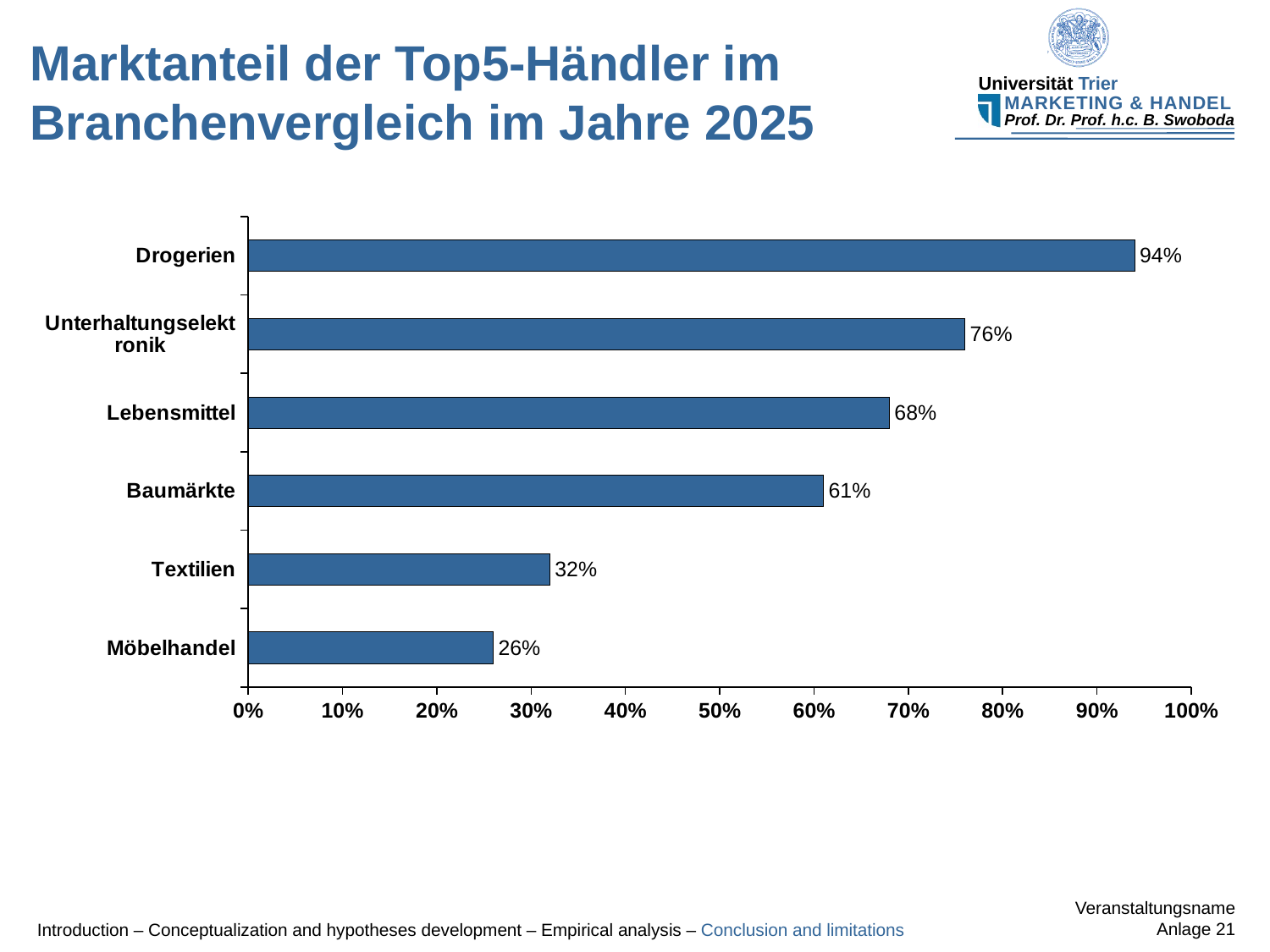
What is the title of the slide? Marktanteil der Top5-Händler im Branchenvergleich im Jahre 2025 What is the value shown for Möbelhandel? 26% What is the difference between the values for Textilien and Möbelhandel? 6% What is the value shown for Lebensmittel? 68% What is the difference between the values for Drogerien and Unterhaltungselektronik? 18% What kind of chart is shown on the slide? Bar chart What is the market share of the top 5 retailers for Drogerien? 94% Which is larger, the value for Baumärkte or the value for Textilien? Baumärkte Is the value for Unterhaltungselektronik greater or less than 70%? greater Which category has the lowest value? Möbelhandel How many categories are shown in the chart? 6 Which category has the highest value? Drogerien